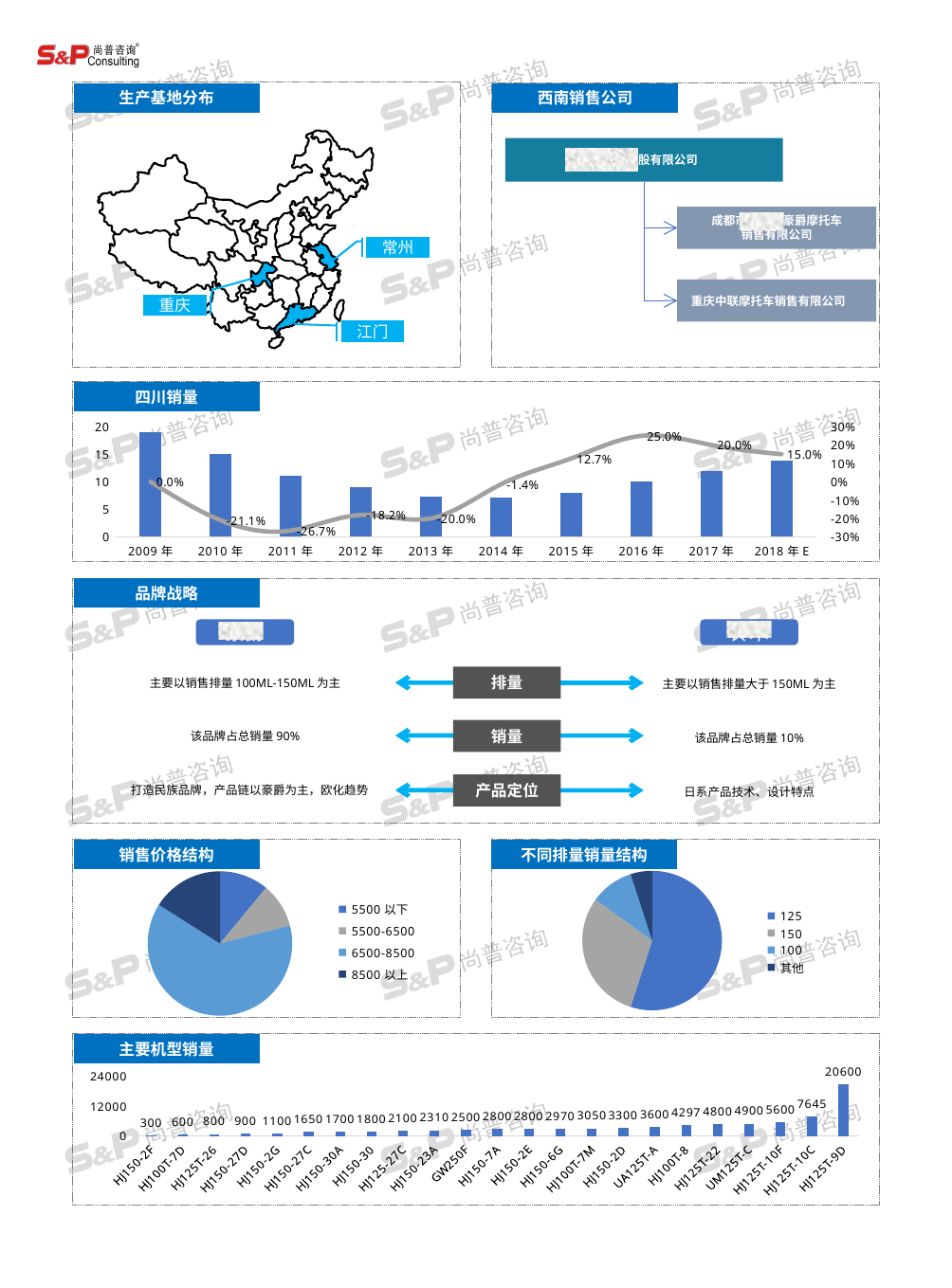
In the 四川销量 chart, what growth rate is labelled for 2011年? -26.7% In the 主要机型销量 chart, what is the difference between the sales of HJ125T-9D and HJ125T-10C? 12955 In the 主要机型销量 chart, which model has the highest sales? HJ125T-9D In the 四川销量 chart, is the bar for 2013年 greater or less than 10? less In the 四川销量 chart, which year has the lowest labelled growth rate on the line? 2011年 How many models are shown in the 主要机型销量 chart? 23 In the 不同排量销量结构 pie chart, which category has the largest slice? 125 In the 四川销量 chart, what growth rate is labelled for 2016年? 25.0% In the 四川销量 chart, is the bar for 2009年 greater or less than 15? greater How many categories does the legend of the 销售价格结构 pie chart list? 4 In the 销售价格结构 pie chart, which category has the largest slice? 6500-8500 In the 主要机型销量 chart, what is the sales value for GW250F? 2500